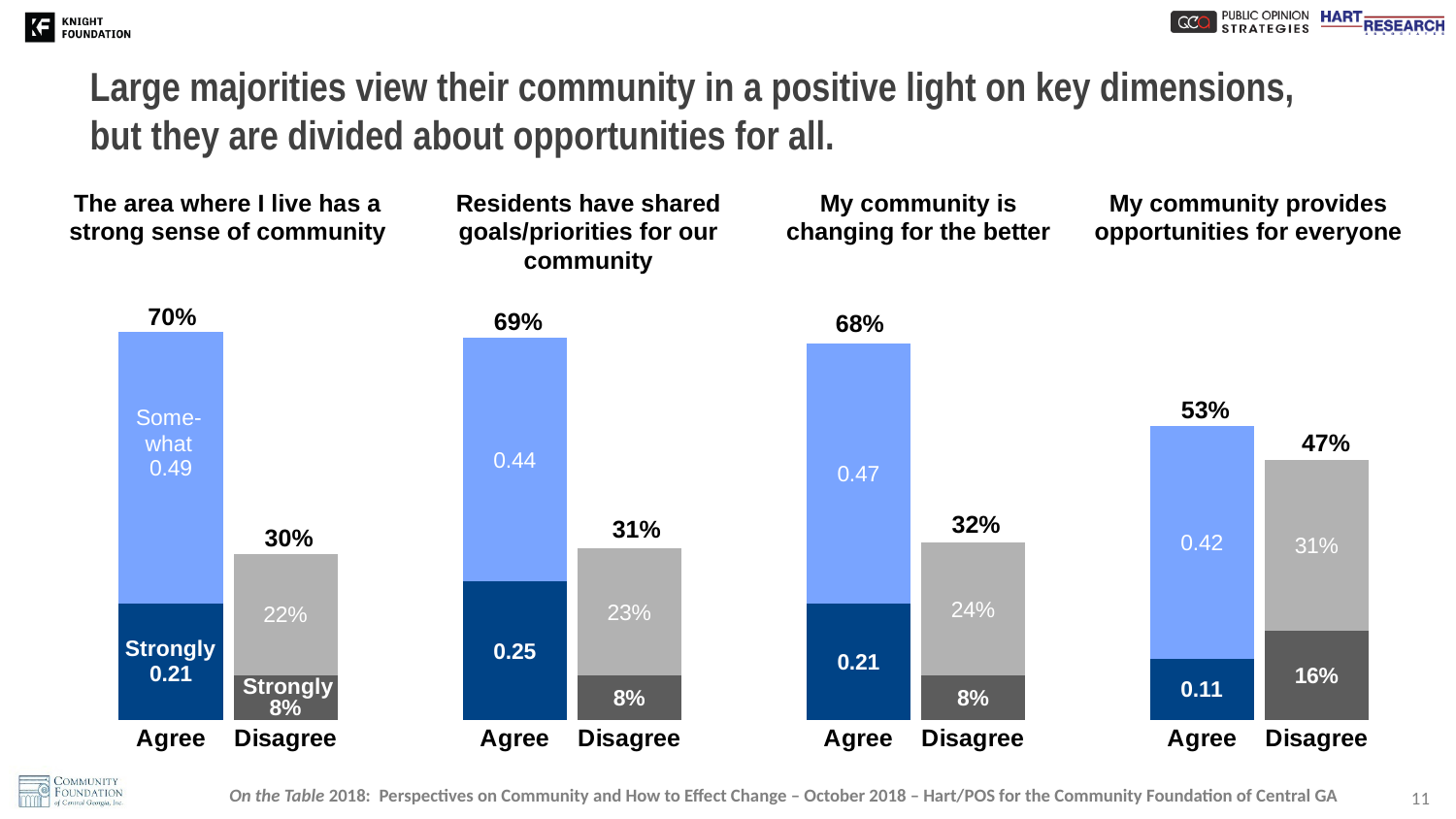
In the chart titled "My community provides opportunities for everyone", what is the strongly disagree value shown at the bottom of the Disagree bar? 16% Across the four charts, which statement has the lowest Agree total? My community provides opportunities for everyone In the chart titled "The area where I live has a strong sense of community", what is the Strongly agree value shown on the Agree bar? 0.21 In the chart titled "Residents have shared goals/priorities for our community", what is the lower (strongly) segment value of the Agree bar? 0.25 In the chart titled "My community is changing for the better", what is the value of the upper segment of the Disagree bar? 24% In the chart titled "My community provides opportunities for everyone", which bar is taller, Agree or Disagree? Agree In the chart titled "My community provides opportunities for everyone", what is the total for the Agree bar? 53% In the chart titled "My community is changing for the better", what is the difference between the Agree total and the Disagree total? 36 percentage points In the chart titled "The area where I live has a strong sense of community", what is the total for the Agree bar? 70% How many bars does each chart on the slide contain? 2 What kind of chart is used on this slide? Stacked bar chart In the chart titled "Residents have shared goals/priorities for our community", what is the total for the Disagree bar? 31%